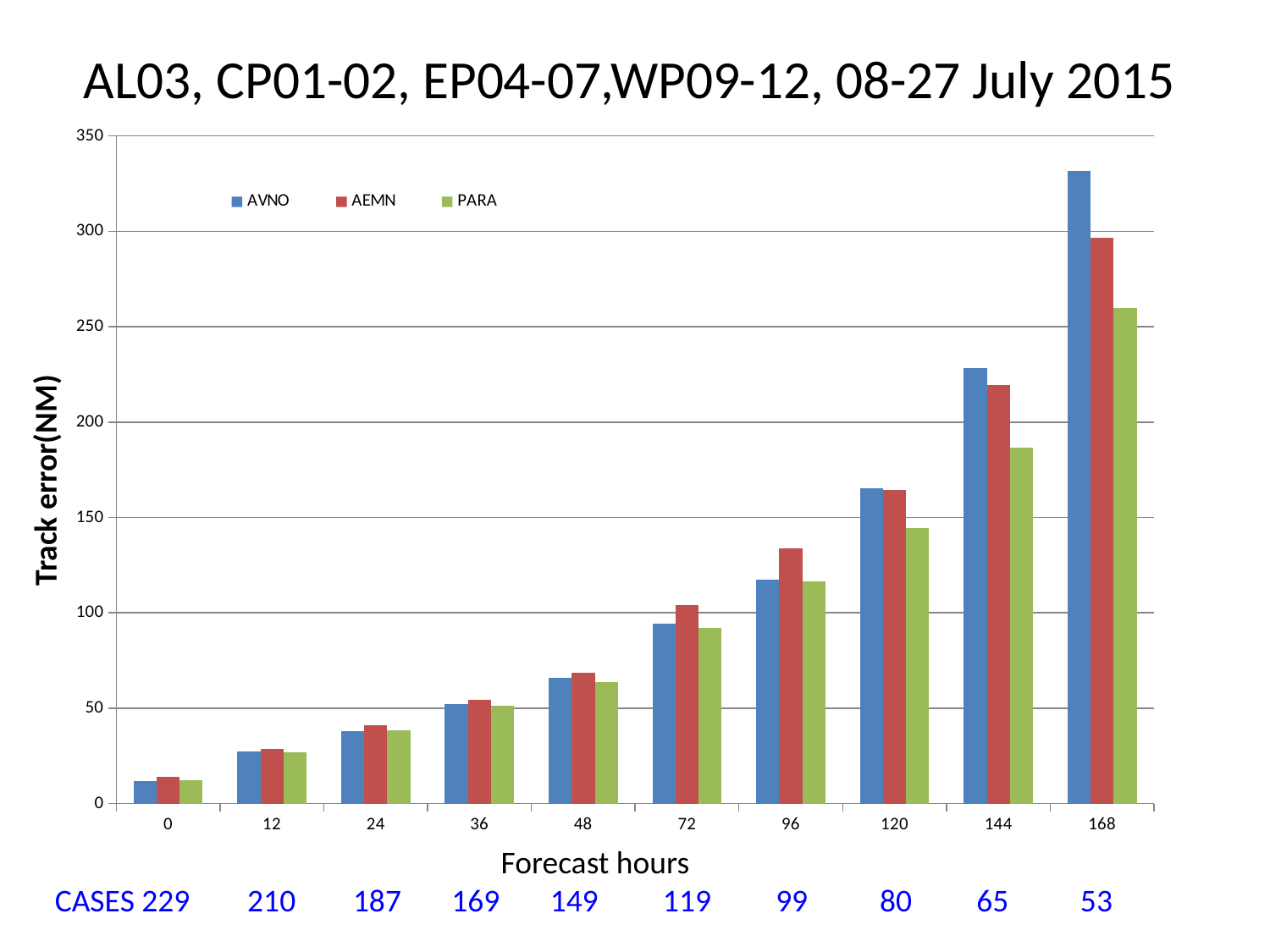
At 168 forecast hours, which series has the highest track error? AVNO Do the track error values rise or fall as forecast hours increase? rise At which forecast hour is the AVNO track error lowest? 0 Is the AEMN value at 96 forecast hours greater or less than 100? greater How many forecast hour categories are shown on the x axis? 10 What is the label of the y axis? Track error(NM) What kind of chart is shown on the slide? bar chart How many series does the legend list? 3 At 96 forecast hours, which is larger, the AEMN value or the PARA value? AEMN Is the AVNO value at 168 forecast hours greater or less than 300? greater Is the PARA value at 144 forecast hours greater or less than 200? less